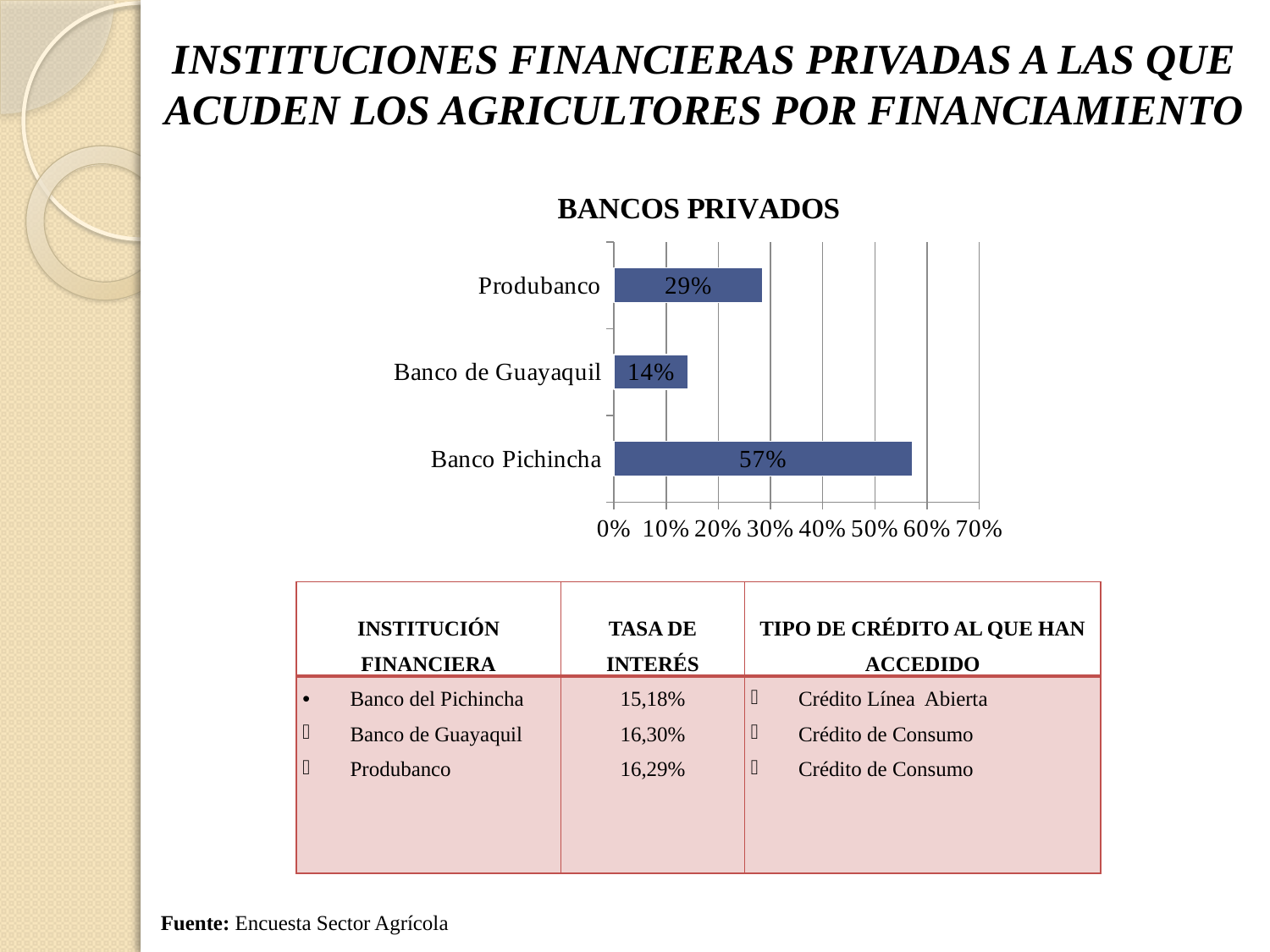
What is the value for Produbanco in the BANCOS PRIVADOS chart? 29% What kind of chart is the BANCOS PRIVADOS chart? Bar chart What is the difference between the values for Banco Pichincha and Produbanco in the BANCOS PRIVADOS chart? 28% Which bank has the highest value in the BANCOS PRIVADOS chart? Banco Pichincha What is the title of the chart on the slide? BANCOS PRIVADOS What is the value for Banco de Guayaquil in the BANCOS PRIVADOS chart? 14% Which bank has the lowest value in the BANCOS PRIVADOS chart? Banco de Guayaquil Is the value for Banco Pichincha in the BANCOS PRIVADOS chart greater or less than 50%? greater Which is larger in the BANCOS PRIVADOS chart, the value for Produbanco or the value for Banco de Guayaquil? Produbanco What is the value for Banco Pichincha in the BANCOS PRIVADOS chart? 57% How many banks are shown in the BANCOS PRIVADOS chart? 3 What is the difference between the values for Produbanco and Banco de Guayaquil in the BANCOS PRIVADOS chart? 15%